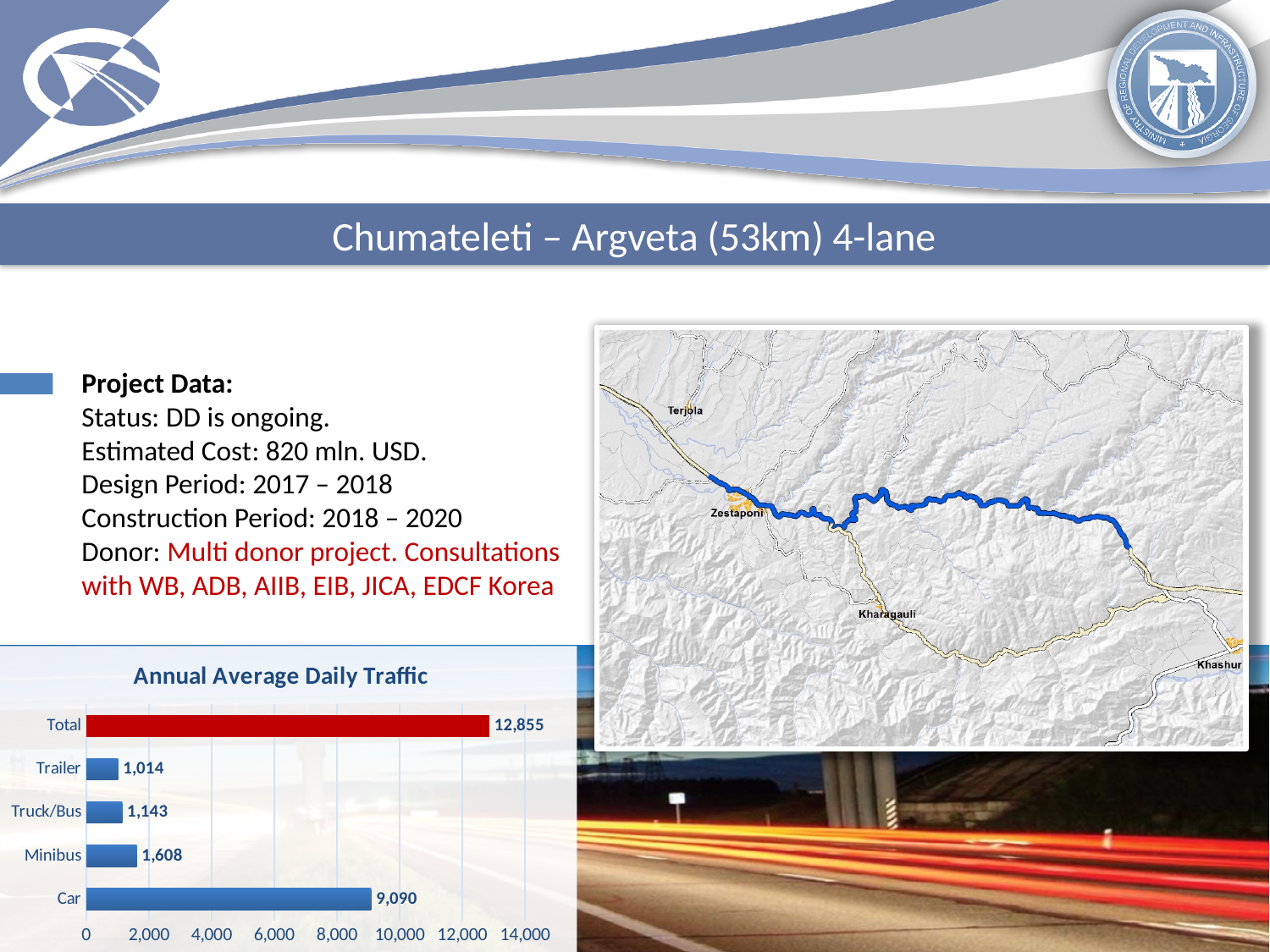
What is the title of the chart on the slide? Annual Average Daily Traffic Which vehicle category has the lowest value in the chart? Trailer Excluding the Total bar, which vehicle category has the highest value? Car Which is larger, the value for Truck/Bus or the value for Trailer? Truck/Bus What is the value for Car in the Annual Average Daily Traffic chart? 9,090 What type of chart is shown on the slide? bar chart What is the value for Trailer in the Annual Average Daily Traffic chart? 1,014 What is the value for Truck/Bus in the Annual Average Daily Traffic chart? 1,143 What is the value for Minibus in the Annual Average Daily Traffic chart? 1,608 What is the difference between the Car value and the Minibus value? 7,482 How many bars are shown in the Annual Average Daily Traffic chart? 5 What is the Total value shown in the Annual Average Daily Traffic chart? 12,855